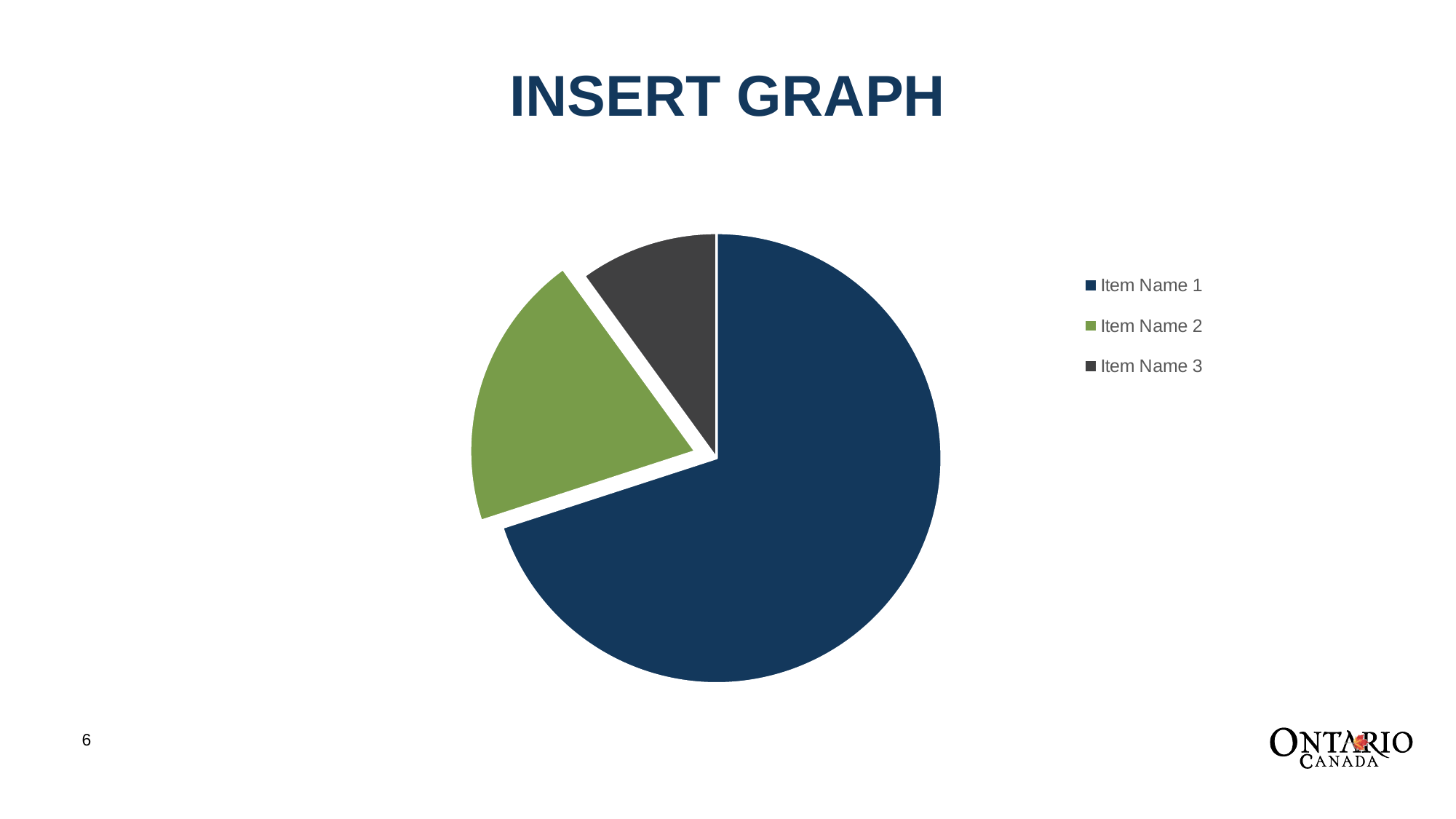
Which item has the largest slice of the pie? Item Name 1 Which item has the smallest slice of the pie? Item Name 3 What colour is the slice for Item Name 2? green How many entries does the legend list? 3 What is the title of the slide containing the pie chart? INSERT GRAPH What kind of chart is shown on the slide? pie chart How many slices does the pie chart have? 3 Which slice is larger, Item Name 1 or Item Name 2? Item Name 1 Which slice is larger, Item Name 2 or Item Name 3? Item Name 2